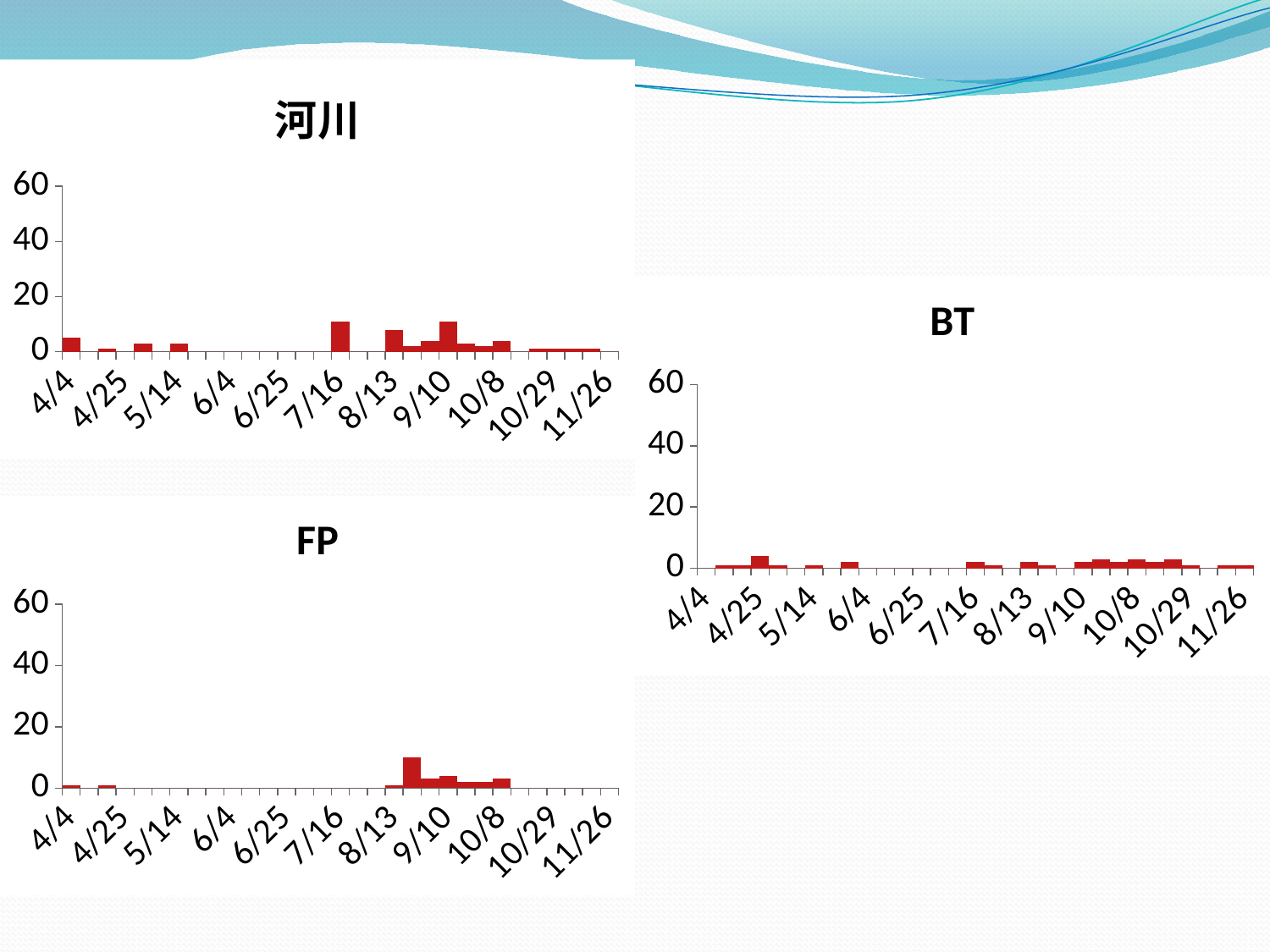
In the 河川 chart, is the highest value greater or less than 20? less In the BT chart, is the highest value greater or less than 20? less In the FP chart, is the highest value greater or less than 20? less What kind of chart is the 河川 chart? bar chart What is the last date label on the x axis of the BT chart? 11/26 What kind of chart is the FP chart? bar chart What is the highest tick value on the y axis of the 河川 chart? 60 Which chart shows a higher value at 4/4, the 河川 chart or the FP chart? 河川 What is the title of the chart on the right side of the slide? BT What is the first date label on the x axis of the FP chart? 4/4 What kind of chart is the BT chart? bar chart